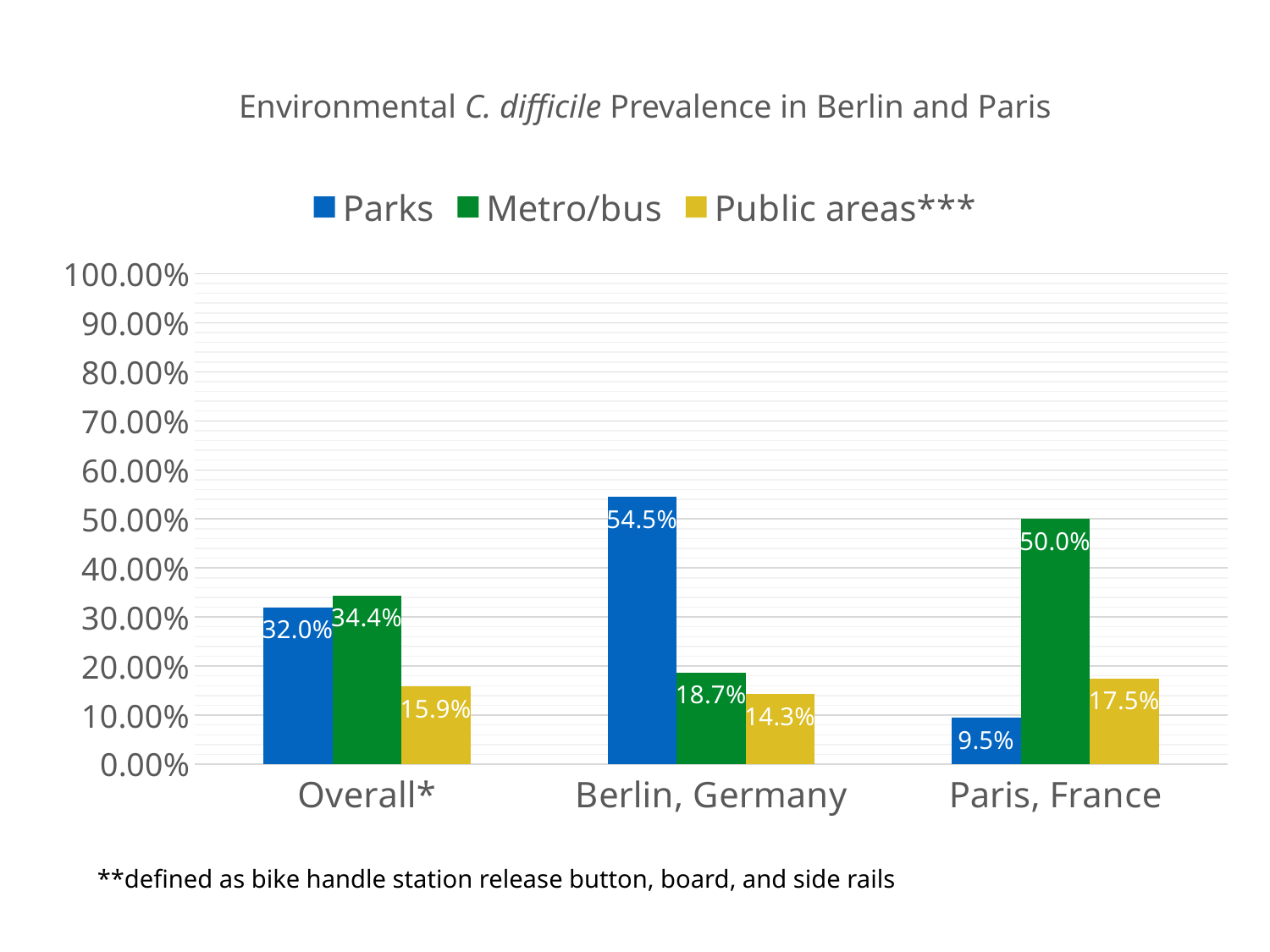
What is the difference between the Parks and Metro/bus values for Berlin, Germany? 35.8% What is the Public areas*** value for Overall*? 15.9% What kind of chart is shown on the slide? bar chart What is the Parks value for Berlin, Germany? 54.5% How many series does the legend list? 3 Which category has the highest Parks value? Berlin, Germany What is the Metro/bus value for Paris, France? 50.0% How many categories are shown on the x axis? 3 Is the Parks value for Overall* greater or less than 40.00%? less What is the Parks value for Paris, France? 9.5% Which category has the lowest Metro/bus value? Berlin, Germany Which is larger for Paris, France: the Metro/bus value or the Public areas*** value? Metro/bus